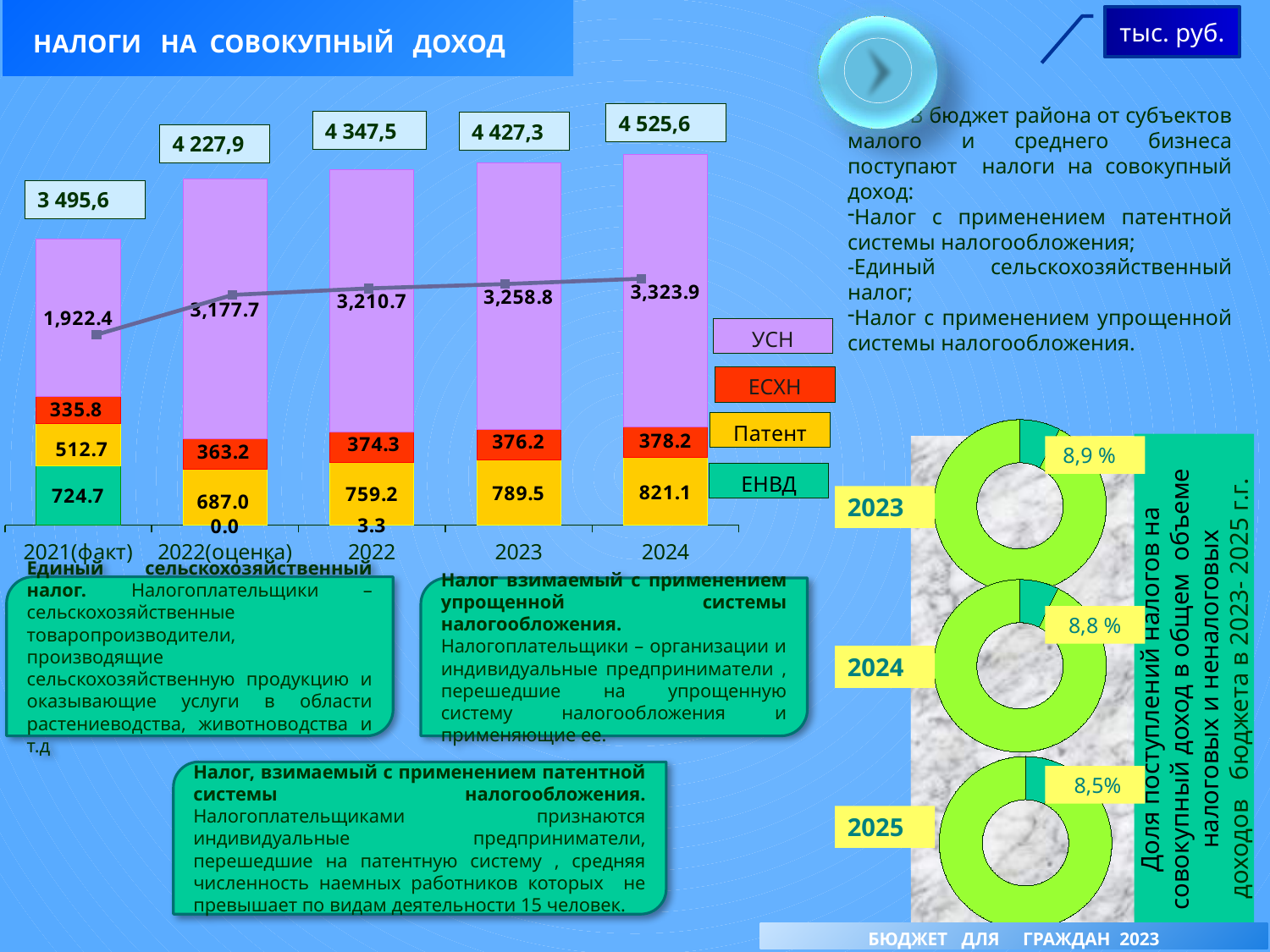
In the stacked bar chart, which category has the highest total value? 2024 In the stacked bar chart, which category has the lowest total value? 2021(факт) In the stacked bar chart, what is the difference between the УСН values for 2024 and 2021(факт)? 1,401.5 In the stacked bar chart, what is the Патент value for 2023? 789.5 Among the donut charts on the right, which year shows the highest share? 2023 How many series does the legend of the stacked bar chart list? 4 In the stacked bar chart, do the УСН values rise or fall from 2021(факт) to 2024? rise In the stacked bar chart, which is larger for 2023: the Патент value or the ЕСХН value? Патент In the stacked bar chart, what is the total value shown above the bar for 2024? 4 525,6 In the stacked bar chart, what is the УСН value for 2021(факт)? 1,922.4 In the donut charts on the right, what share is shown for 2025? 8,5% In the stacked bar chart, what is the ЕСХН value for 2022(оценка)? 363.2